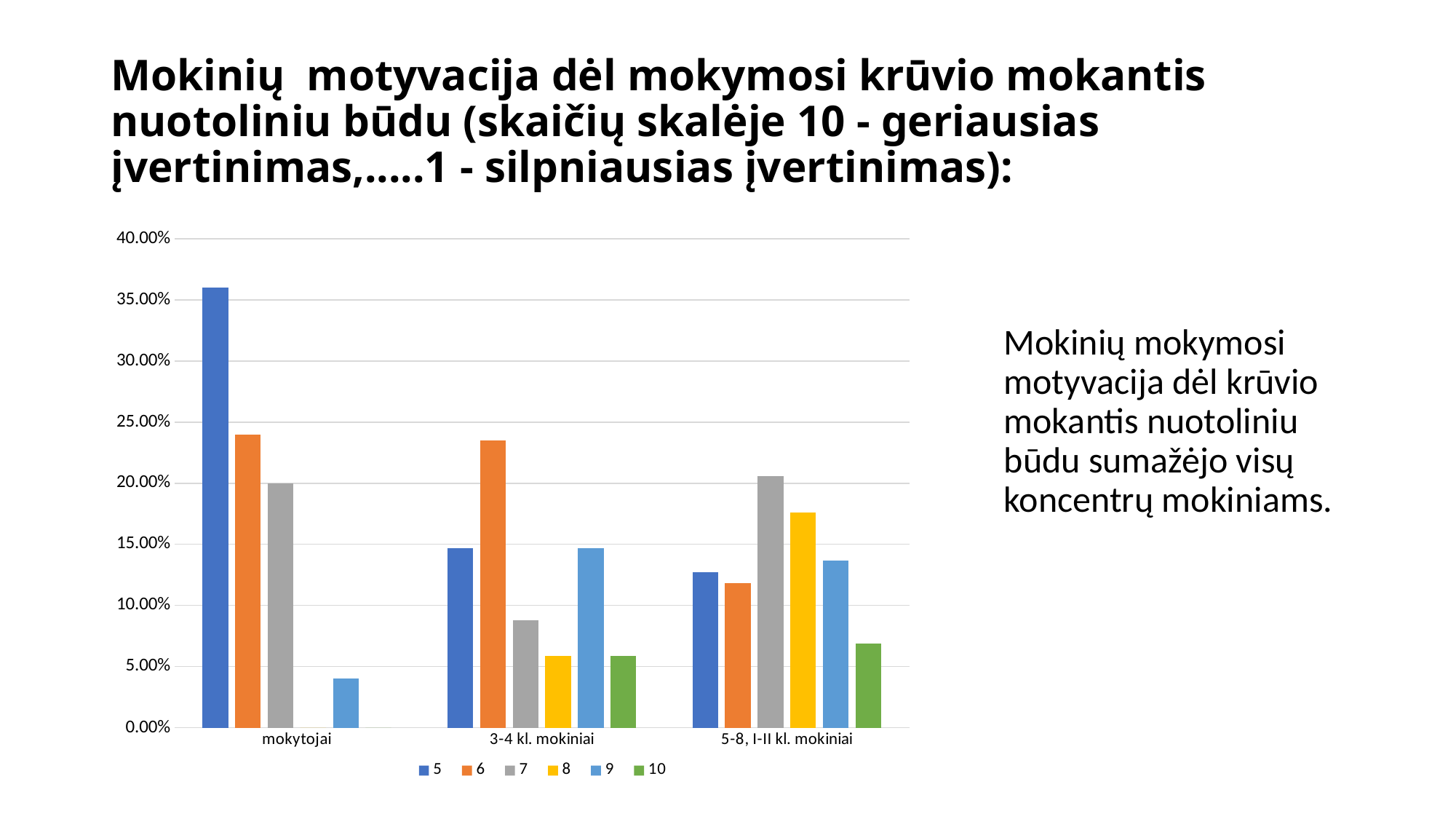
Which series has the lowest value for 5-8, I-II kl. mokiniai? 10 Is the value of series 8 for 5-8, I-II kl. mokiniai greater or less than 15.00%? greater Is the value of series 9 for mokytojai greater or less than 5.00%? less Which is larger for 3-4 kl. mokiniai: series 6 or series 7? 6 Which series has the lowest value for mokytojai? 8 and 10 Which series has the highest value for mokytojai? 5 How many series does the legend list? 6 Which series has the highest value for 5-8, I-II kl. mokiniai? 7 How many categories are shown on the x axis? 3 Which series has the highest value for 3-4 kl. mokiniai? 6 What kind of chart is shown on the slide? bar chart Is the value of series 5 for mokytojai greater or less than 35.00%? greater